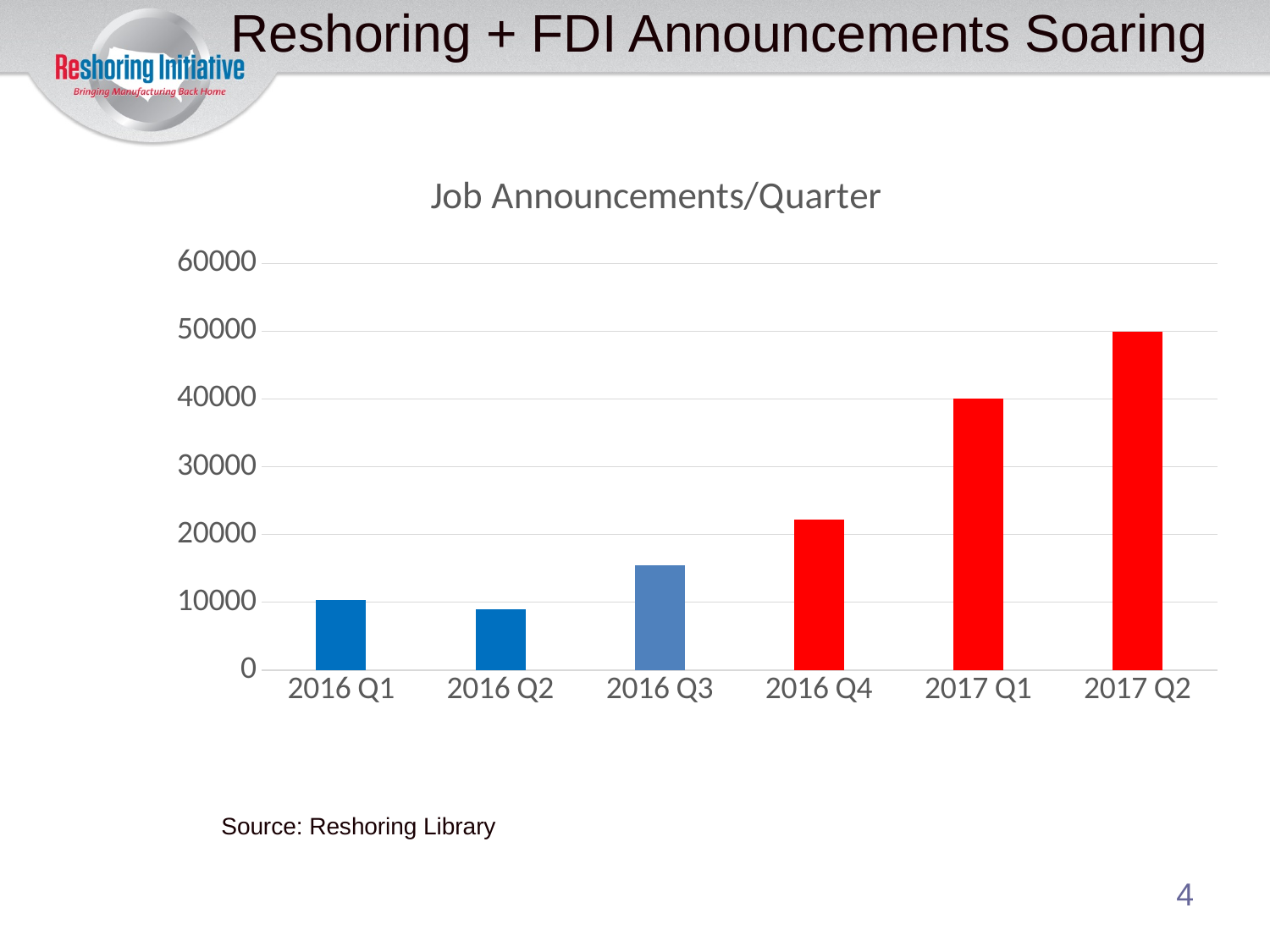
Which quarter has more job announcements, 2016 Q1 or 2016 Q2? 2016 Q1 How many quarters are shown on the x axis of the chart? 6 Do job announcements generally rise or fall from 2016 Q2 to 2017 Q2? rise Is the value for 2017 Q1 greater or less than 30000? greater What kind of chart is shown on the slide? bar chart What is the title of the chart? Job Announcements/Quarter Is the value for 2016 Q4 greater or less than 20000? greater Which quarter has more job announcements, 2016 Q3 or 2016 Q4? 2016 Q4 Which quarter has the lowest number of job announcements? 2016 Q2 Is the value for 2016 Q2 greater or less than 10000? less Which quarter has the highest number of job announcements? 2017 Q2 What colour are the bars for the 2016 Q4, 2017 Q1 and 2017 Q2 quarters? red